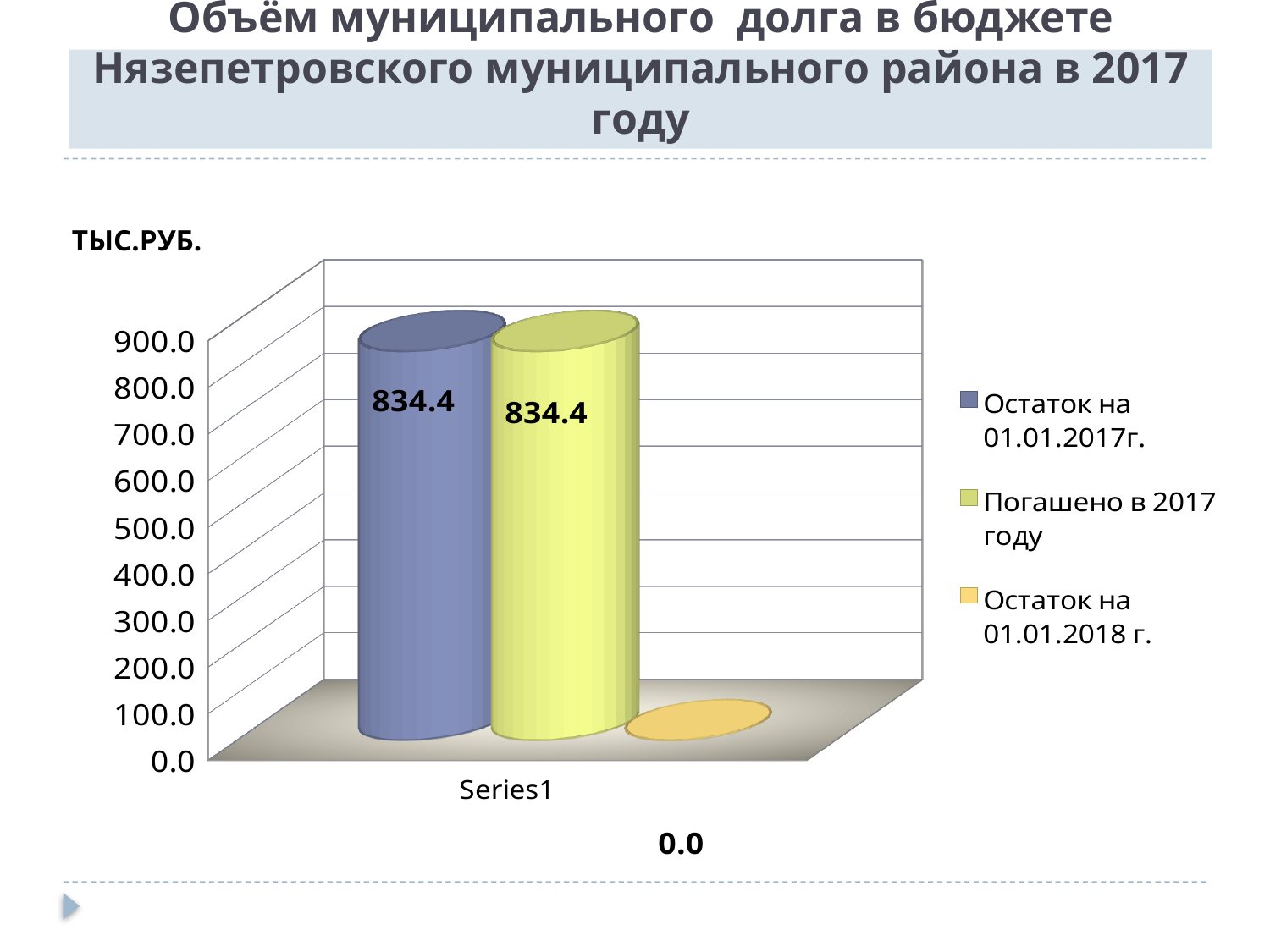
Which is larger, "Погашено в 2017 году" or "Остаток на 01.01.2018 г."? Погашено в 2017 году What is the difference between "Остаток на 01.01.2017г." and "Остаток на 01.01.2018 г."? 834.4 Is the value for "Остаток на 01.01.2017г." greater or less than 800.0? greater What unit is indicated above the chart's vertical axis? ТЫС.РУБ. What is the value for "Остаток на 01.01.2017г."? 834.4 Which series has the lowest value? Остаток на 01.01.2018 г. What kind of chart is shown on the slide? bar chart How many series does the legend list? 3 What is the value for "Остаток на 01.01.2018 г."? 0.0 What is the value for "Погашено в 2017 году"? 834.4 What is the highest value shown on the vertical axis? 900.0 What is the difference between "Остаток на 01.01.2017г." and "Погашено в 2017 году"? 0.0